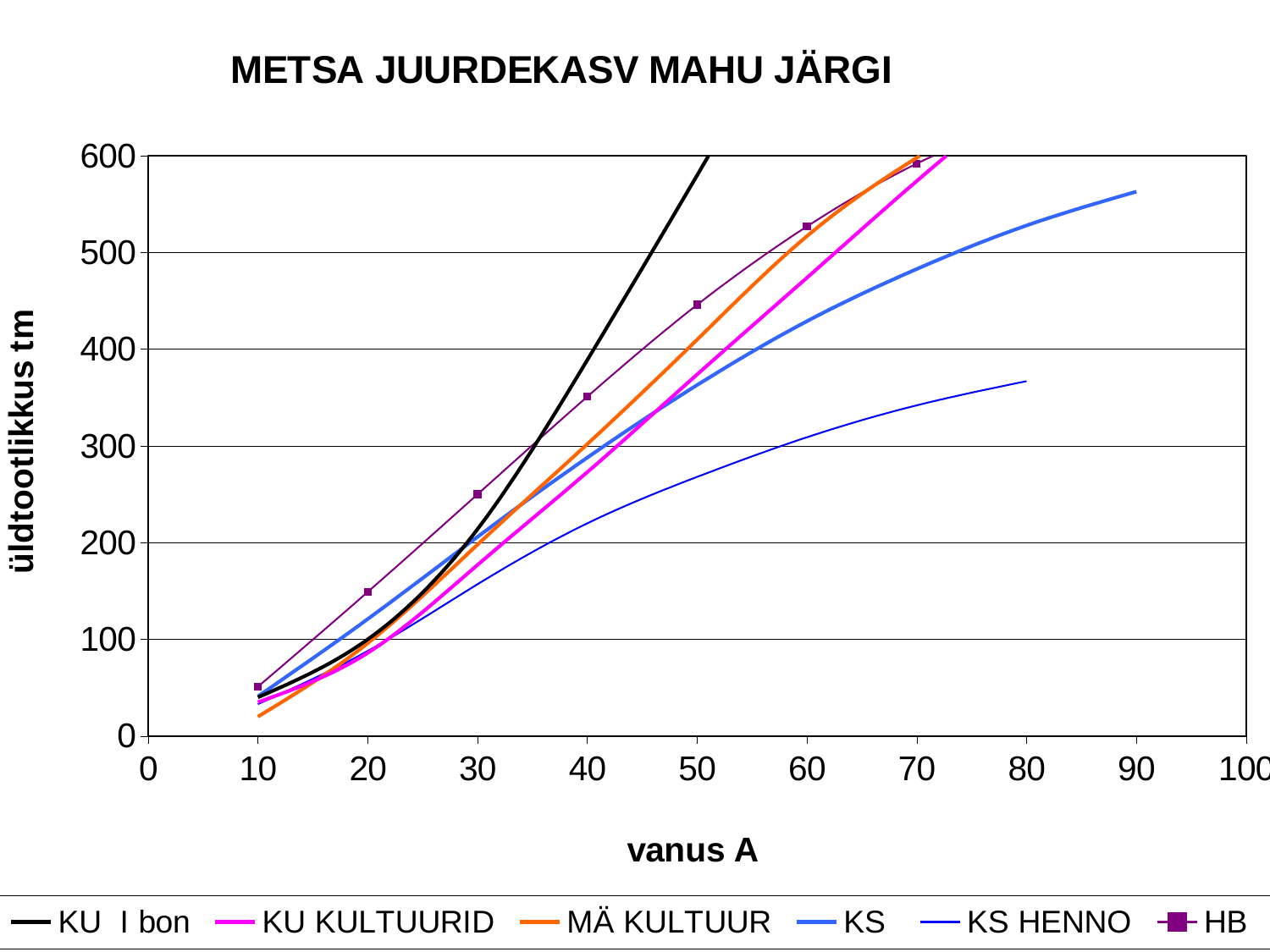
Is the value for HB at vanus A = 40 greater or less than 300? greater What kind of chart is shown on the slide? line chart What is the label of the x axis? vanus A At vanus A = 80, which series has the larger value, KS or KS HENNO? KS Is the value for HB at vanus A = 30 greater or less than 200? greater How many series does the legend list? 6 Do the values of the KS series rise or fall as vanus A increases? rise What is the title of the chart? METSA JUURDEKASV MAHU JÄRGI Is the value for KS HENNO at vanus A = 80 greater or less than 400? less At vanus A = 40, which series has the larger value, KU I bon or KS HENNO? KU I bon